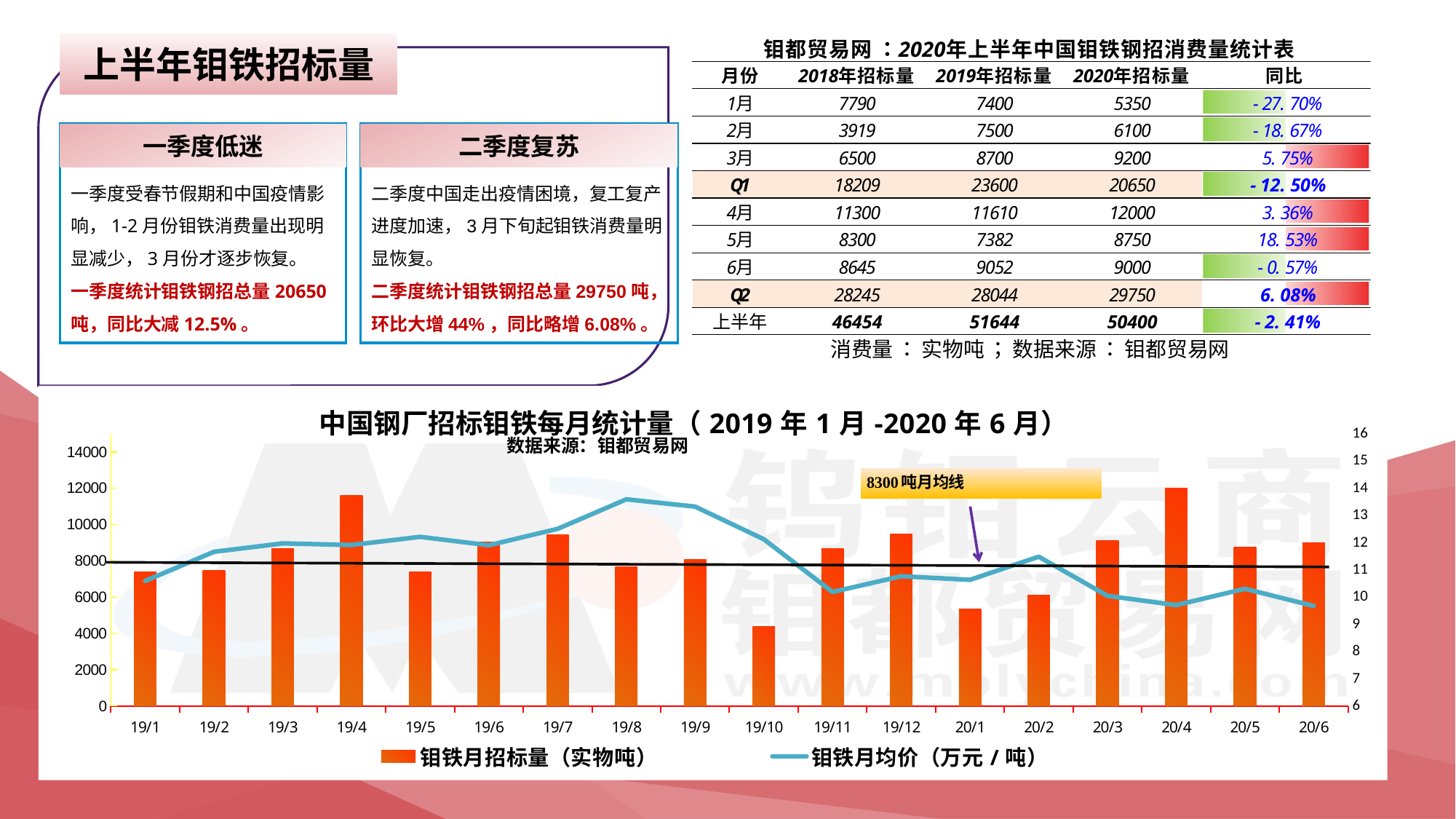
What does the label on the horizontal black line in the bottom chart say? 8300吨月均线 How many months are plotted along the x axis of the bottom chart? 18 Is the 钼铁月均价 value for 19/8 greater or less than 12 on the right axis? greater Do the 钼铁月招标量 bars rise or fall from 20/1 to 20/4? rise Which month has the higher 钼铁月均价 line value, 19/8 or 20/1? 19/8 Is the 钼铁月招标量 bar for 19/4 greater or less than 10000? greater Which month has the lowest bar for 钼铁月招标量 in the bottom chart? 19/10 Which month has the larger 钼铁月招标量 bar, 19/4 or 19/5? 19/4 In which month does the 钼铁月均价 line reach its highest point? 19/8 Is the 钼铁月招标量 bar for 19/10 greater or less than 6000? less What kind of chart is shown at the bottom of the slide? A combined bar and line chart How many series does the legend of the bottom chart list? 2